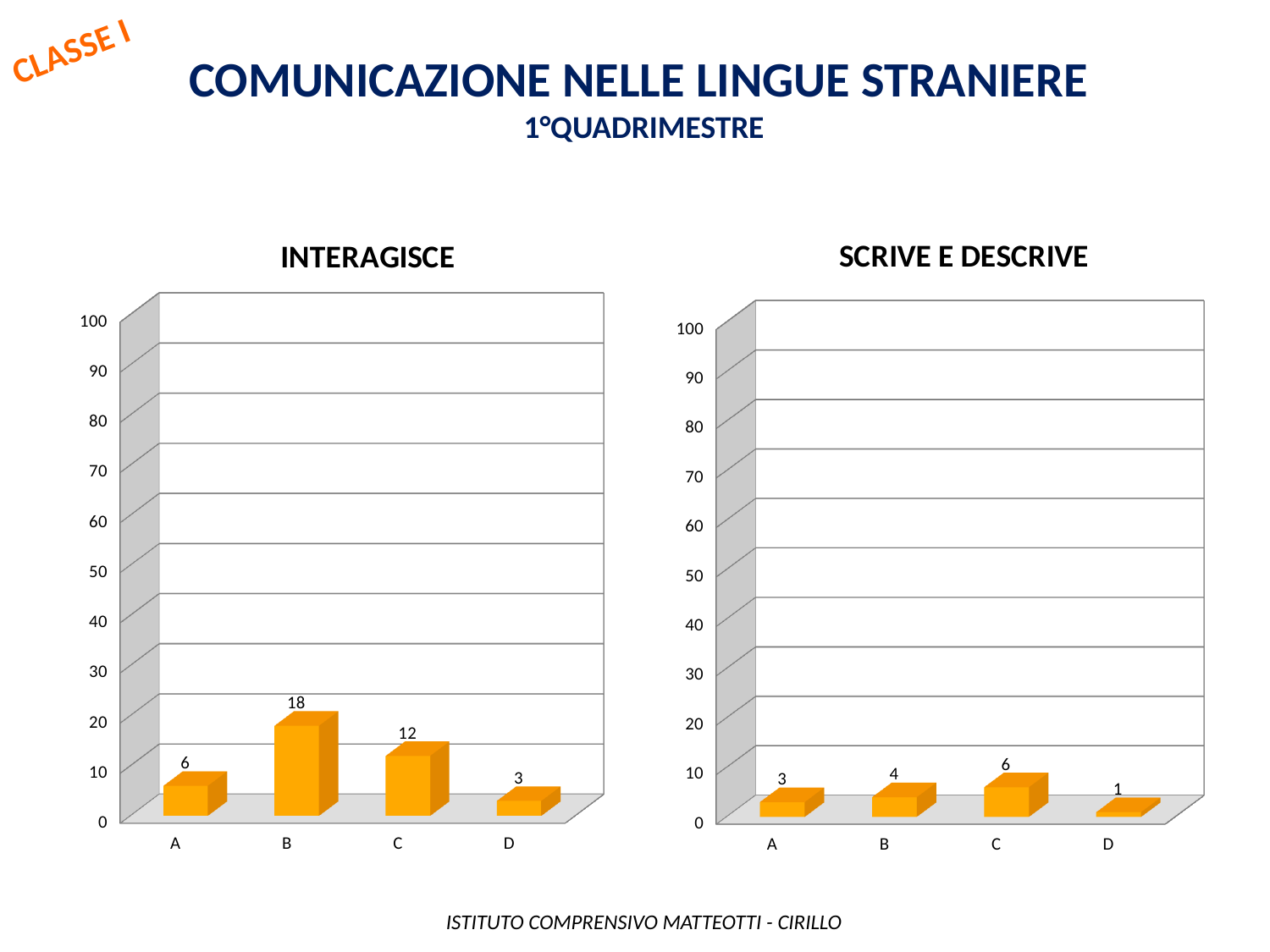
In the INTERAGISCE chart, what is the difference between the values for B and C? 6 In the INTERAGISCE chart, which is larger, the value for A or the value for C? C In the INTERAGISCE chart, what is the value for category D? 3 In the INTERAGISCE chart, which category has the highest value? B What kind of chart is the INTERAGISCE chart? bar chart In the INTERAGISCE chart, is the value for B greater or less than 10? greater In the INTERAGISCE chart, what is the value for category B? 18 In the SCRIVE E DESCRIVE chart, what is the difference between the values for C and D? 5 In the SCRIVE E DESCRIVE chart, which category has the lowest value? D In the SCRIVE E DESCRIVE chart, what is the value for category C? 6 In the SCRIVE E DESCRIVE chart, what is the value for category A? 3 How many categories are shown in the SCRIVE E DESCRIVE chart? 4